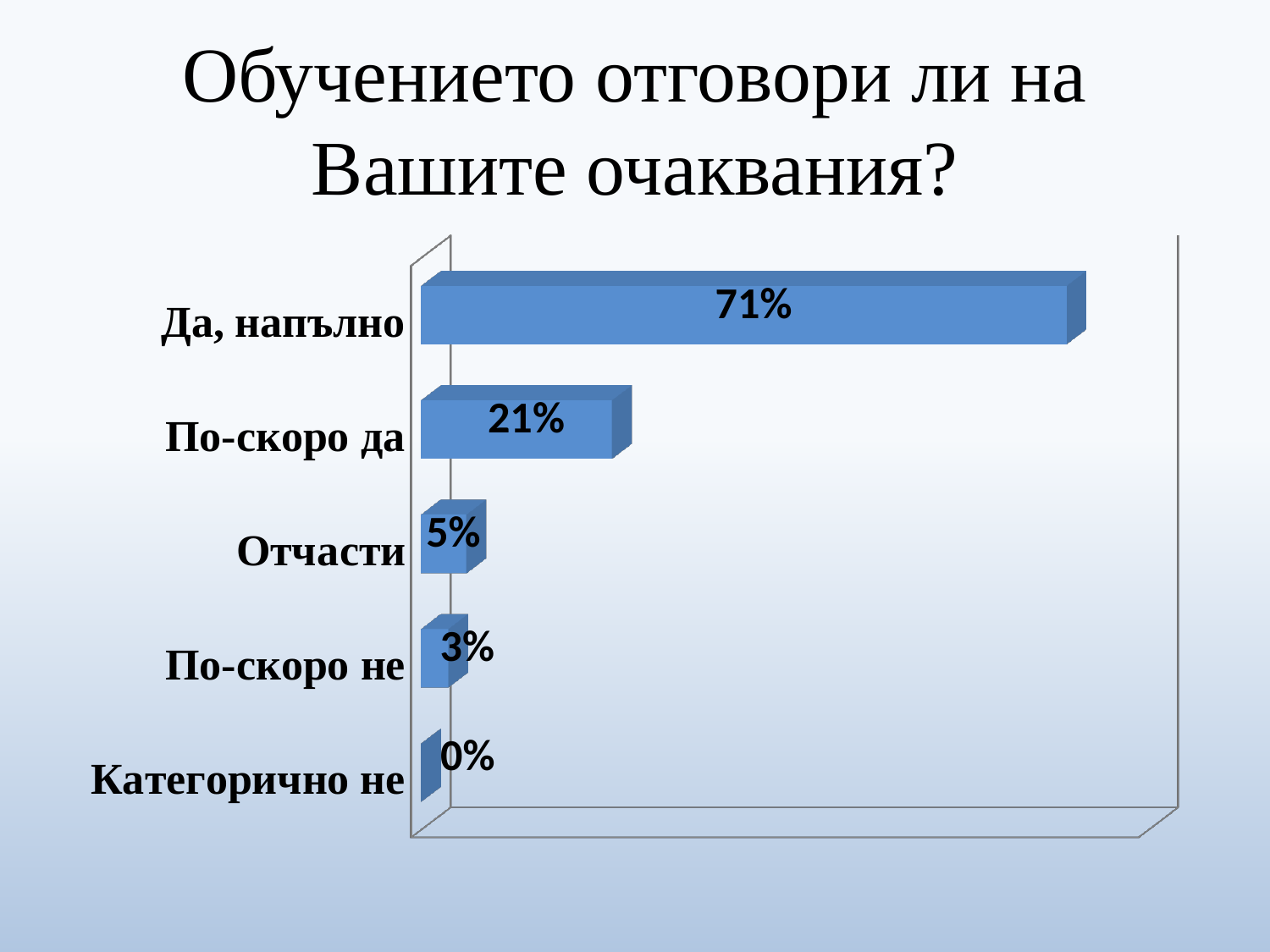
What is the value for "Да, напълно"? 71% What is the value for "Категорично не"? 0% What is the value for "По-скоро не"? 3% How many categories are shown in the chart? 5 What is the title of the slide? Обучението отговори ли на Вашите очаквания? What is the value for "Отчасти"? 5% Which category has the highest value? Да, напълно Which category has the lowest value? Категорично не What kind of chart is shown on the slide? Bar chart Which is larger, the value for "Отчасти" or the value for "По-скоро не"? Отчасти What is the value for "По-скоро да"? 21% What is the difference between the values for "Да, напълно" and "По-скоро да"? 50%